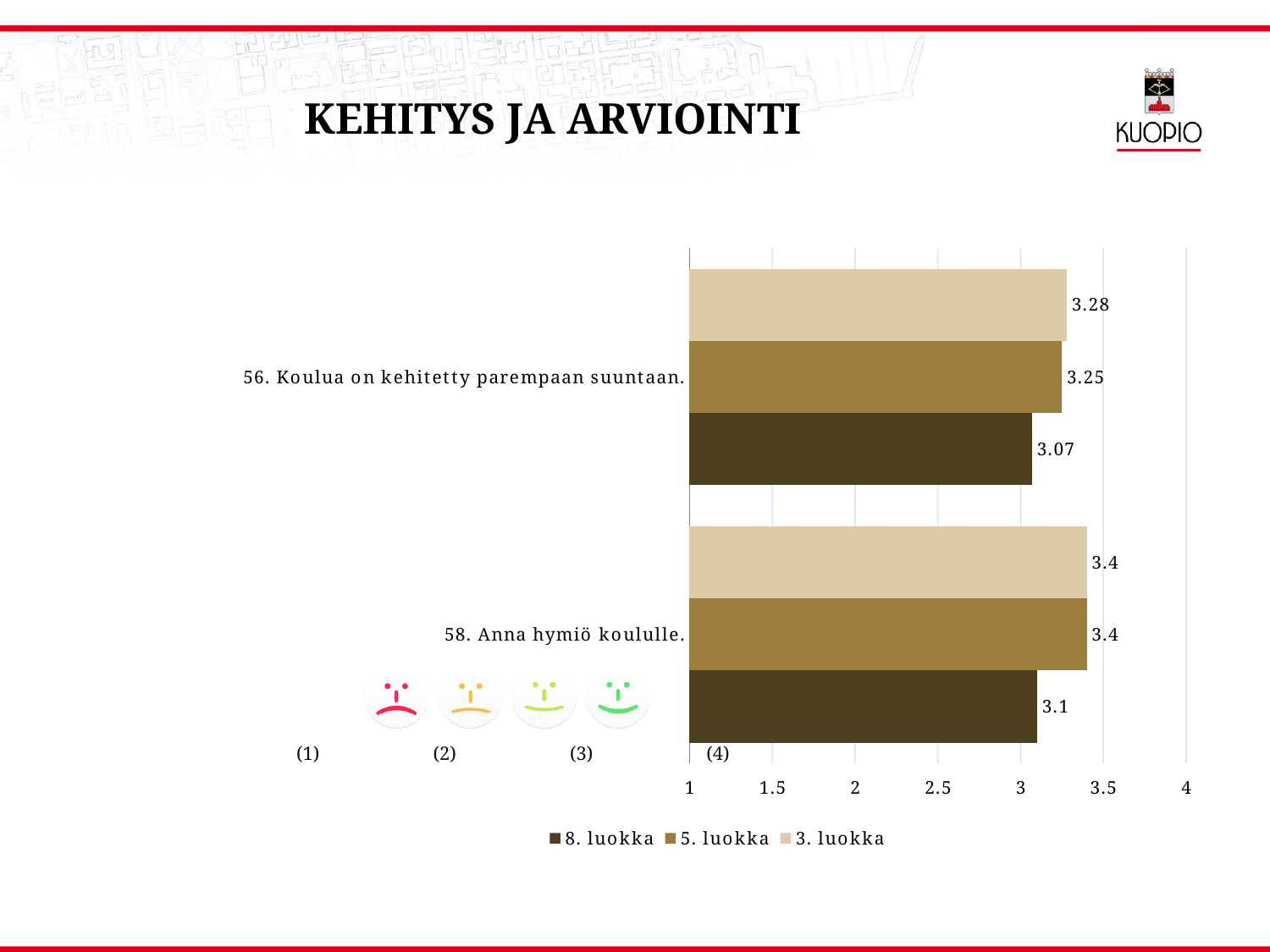
What is the difference between the 3. luokka and 8. luokka values on "56. Koulua on kehitetty parempaan suuntaan."? 0.21 What is the value for 3. luokka on "58. Anna hymiö koululle."? 3.4 How many series does the legend list? 3 How many categories are shown on the chart? 2 What is the value for 5. luokka on "56. Koulua on kehitetty parempaan suuntaan."? 3.25 What kind of chart is shown on the slide? Bar chart What is the value for 3. luokka on "56. Koulua on kehitetty parempaan suuntaan."? 3.28 What is the value for 8. luokka on "56. Koulua on kehitetty parempaan suuntaan."? 3.07 Which series has the lowest value on "58. Anna hymiö koululle."? 8. luokka Which series has the lowest value on "56. Koulua on kehitetty parempaan suuntaan."? 8. luokka Which is larger on "58. Anna hymiö koululle.": the 5. luokka value or the 8. luokka value? 5. luokka What is the value for 8. luokka on "58. Anna hymiö koululle."? 3.1